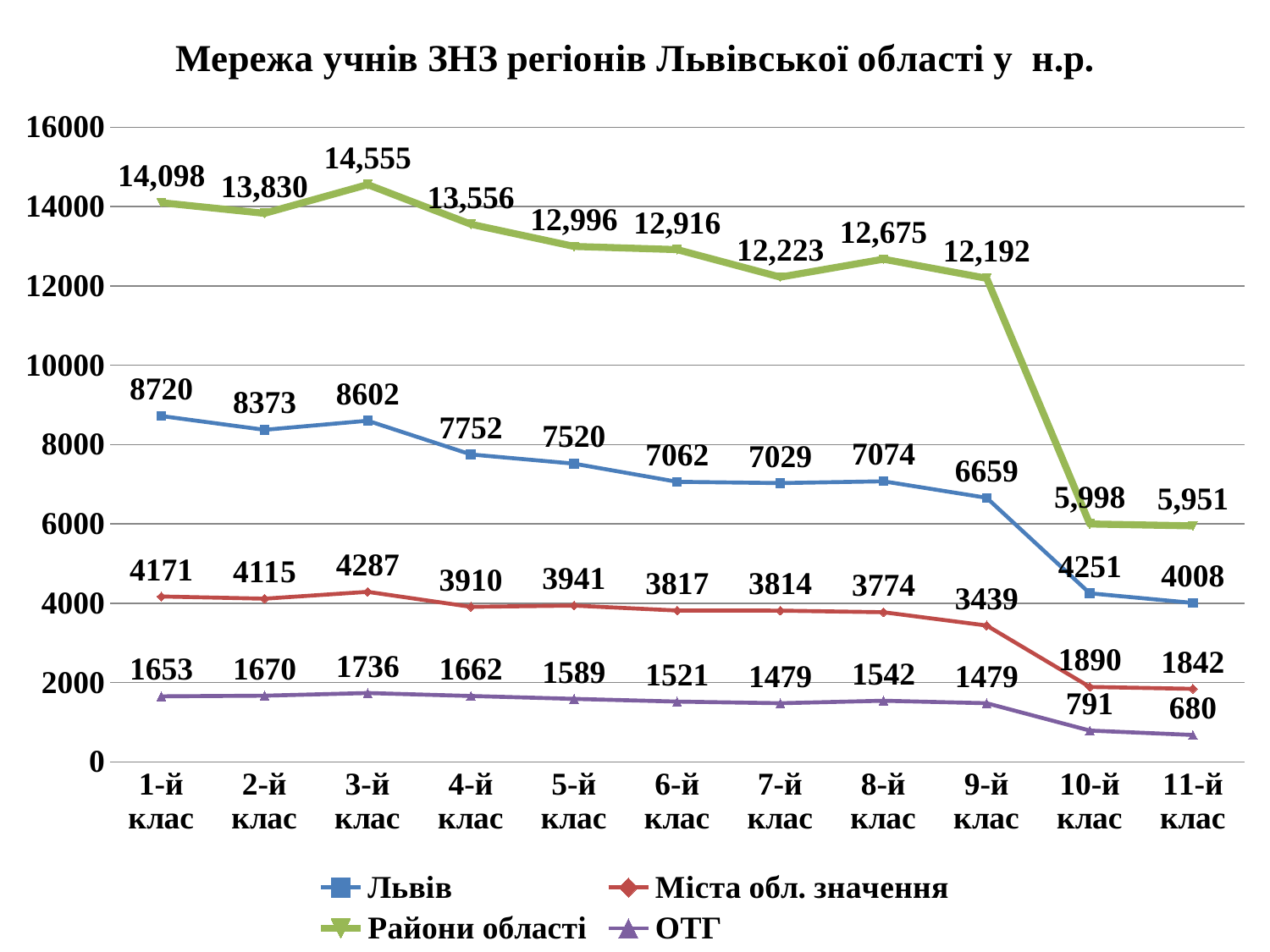
What is the value for Райони області in 7-й клас? 12,223 How many series does the legend list? 4 What is the value for Львів in 3-й клас? 8602 In which class does the Міста обл. значення series have its lowest value? 11-й клас Do the Райони області values generally rise or fall from 1-й клас to 11-й клас? fall What type of chart is shown on the slide? line chart In which class does the Райони області series reach its highest value? 3-й клас Which is larger: the Міста обл. значення value in 4-й клас or in 5-й клас? 5-й клас What is the value for ОТГ in 11-й клас? 680 How many class categories are shown on the x axis? 11 What is the difference between the Львів values for 9-й клас and 10-й клас? 2408 What is the title of the chart? Мережа учнів ЗНЗ регіонів Львівської області у н.р.